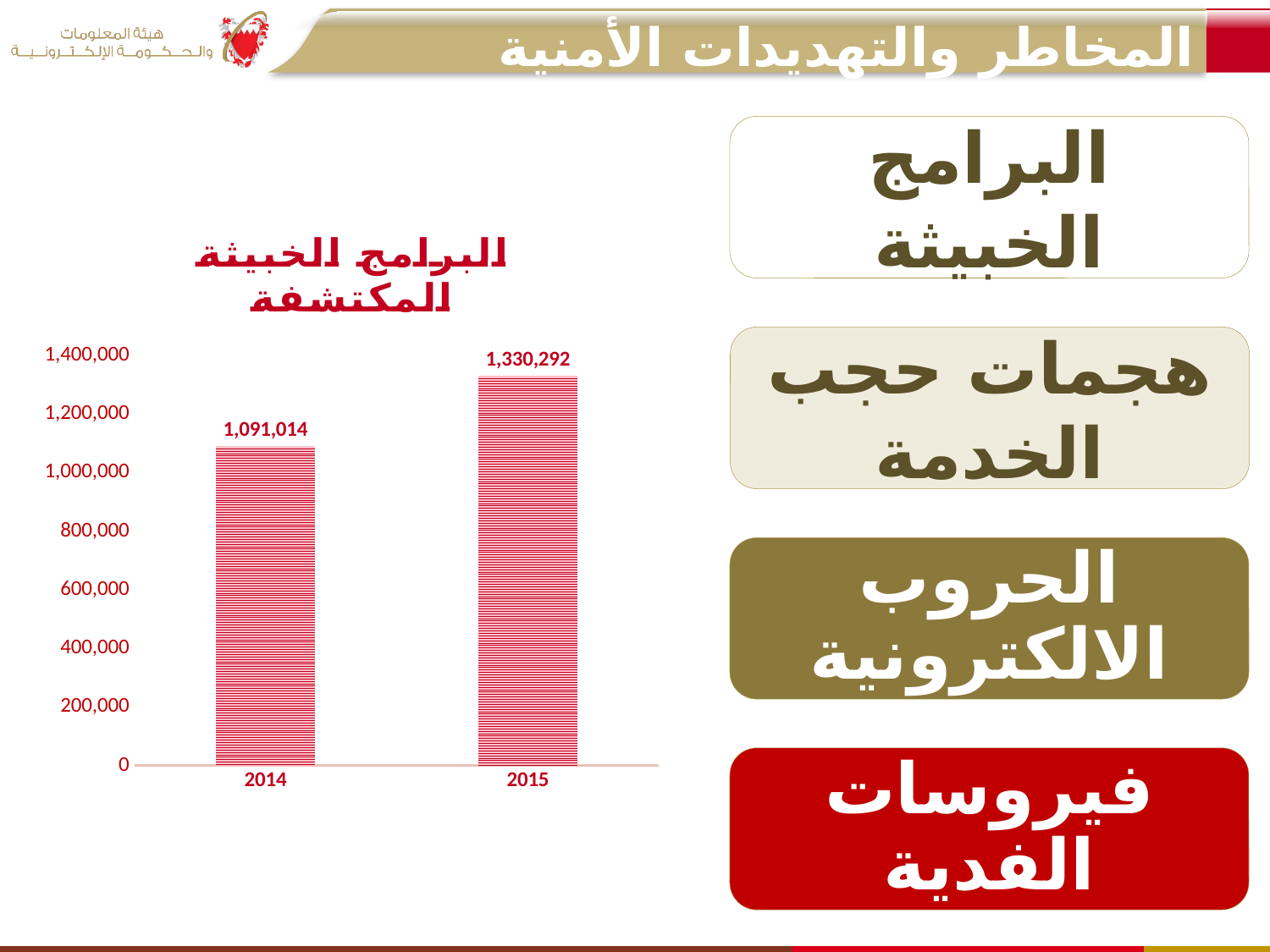
Is the value for 2015 greater or less than 1,400,000? less What is the value for 2014? 1,091,014 Which is larger, the value for 2014 or the value for 2015? 2015 What is the difference between the values for 2015 and 2014? 239,278 Which year has the lowest value? 2014 Which year has the highest value? 2015 What is the title of the chart? البرامج الخبيثة المكتشفة Do the values rise or fall from 2014 to 2015? rise Is the value for 2014 greater or less than 1,000,000? greater What is the value for 2015? 1,330,292 What kind of chart is shown on the slide? bar chart How many years are shown on the x axis? 2